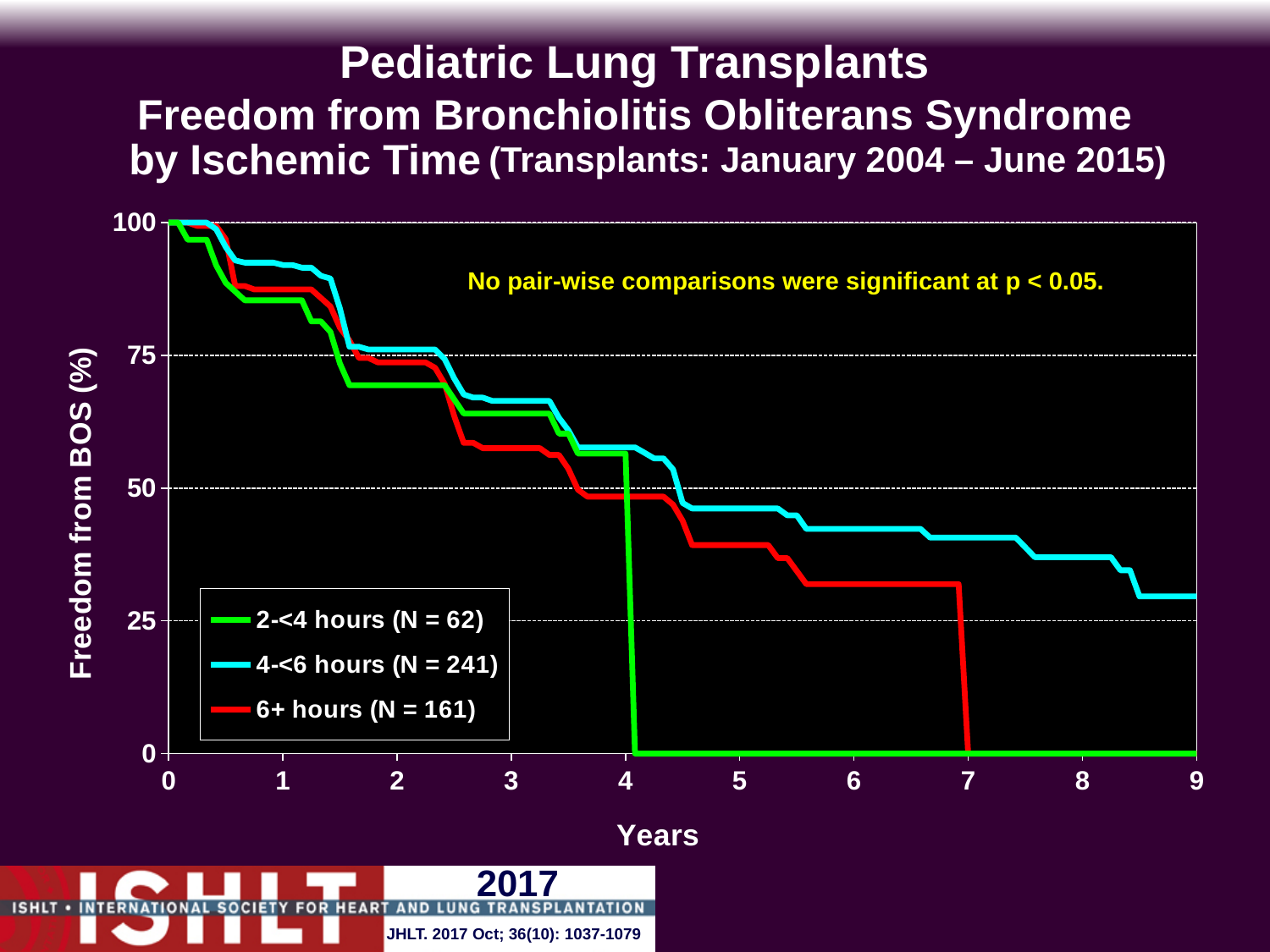
At year 6, which group has the higher freedom from BOS: 4-<6 hours or 6+ hours? 4-<6 hours What kind of chart is shown on the slide? line chart Do the freedom from BOS values rise or fall as years increase? fall Is the value for the 2-<4 hours group at year 3 greater or less than 50? greater Is the value for the 6+ hours group at year 6 greater or less than 25? greater Is the value for the 4-<6 hours group at year 6 greater or less than 50? less Which group has the highest freedom from BOS at year 6? 4-<6 hours At year 1, which group has the higher freedom from BOS: 2-<4 hours or 4-<6 hours? 4-<6 hours What is the sample size (N) for the 4-<6 hours group shown in the legend? 241 What is the sample size (N) for the 2-<4 hours group shown in the legend? 62 How many series does the legend list? 3